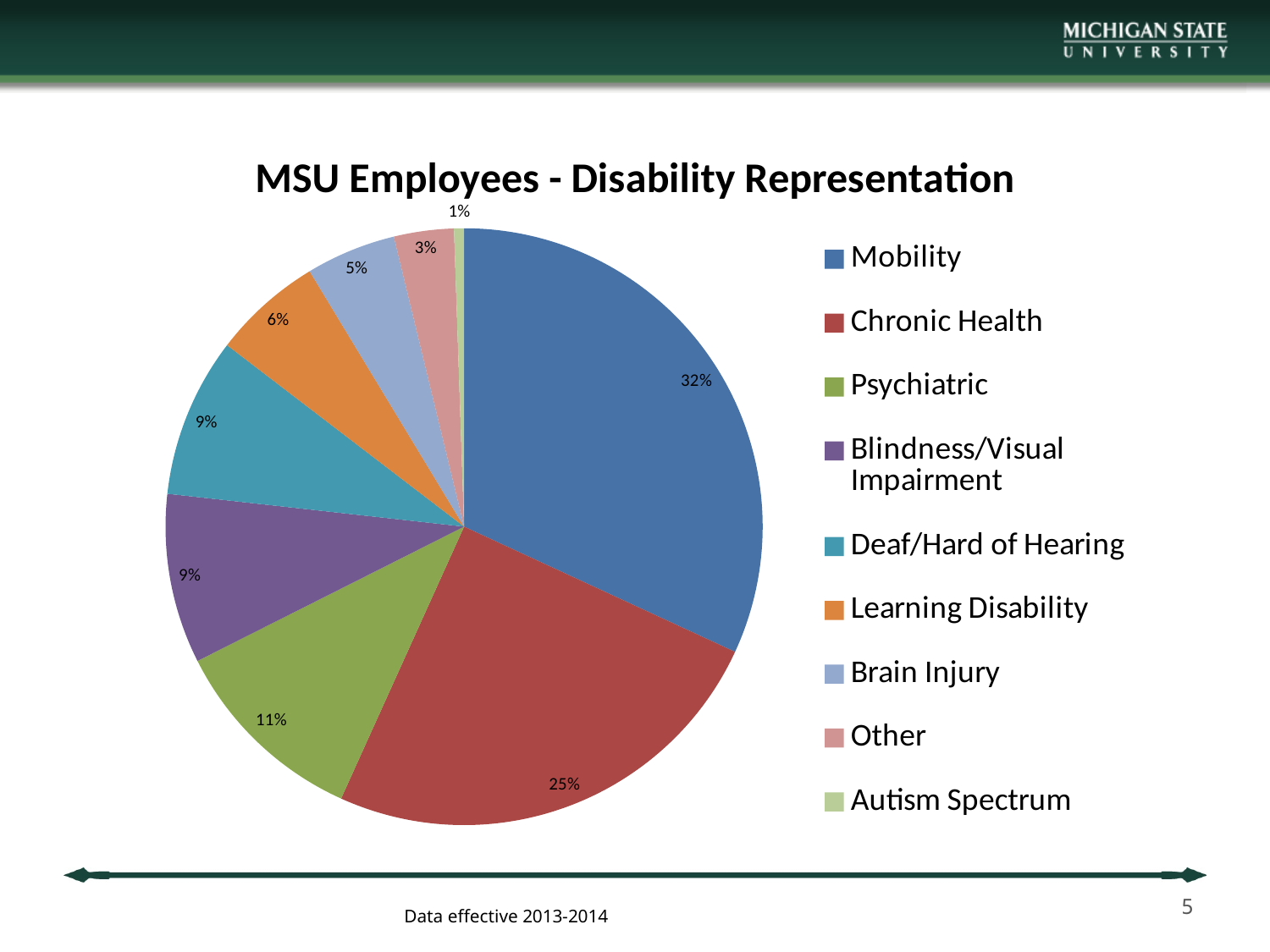
Which category has the largest share of the pie? Mobility What percentage is shown for Learning Disability? 6% Which is larger, the share for Brain Injury or the share for Other? Brain Injury What percentage of the pie does Mobility represent? 32% What is the difference in percentage points between Mobility and Chronic Health? 7 Which category has the smallest share of the pie? Autism Spectrum What kind of chart is shown on the slide? Pie chart What is the title of the chart? MSU Employees - Disability Representation What percentage is shown for Psychiatric? 11% How many categories does the legend list? 9 What percentage is shown for Autism Spectrum? 1% What percentage is shown for Chronic Health? 25%